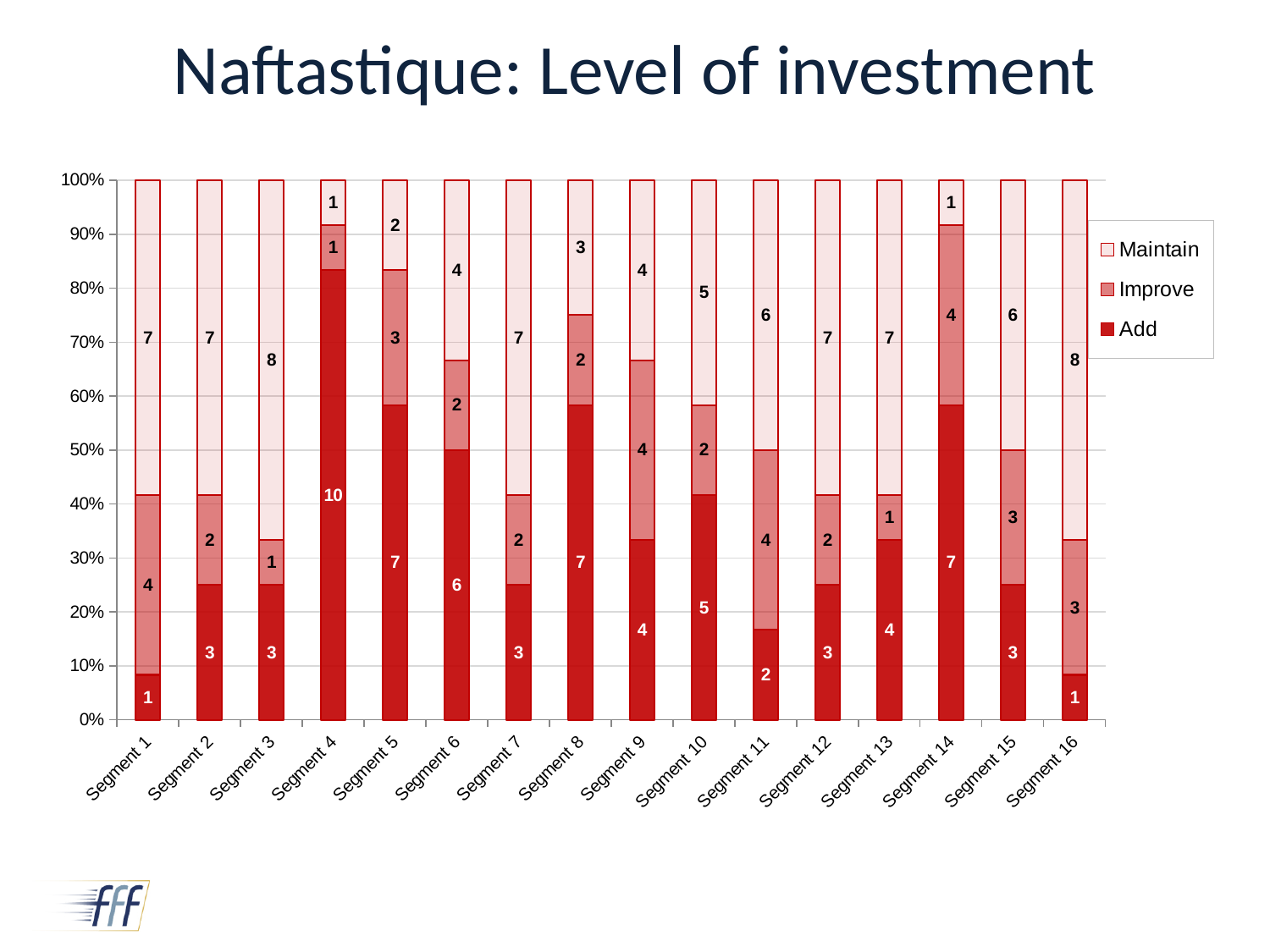
Which segment has the highest Add value? Segment 4 What kind of chart is shown on the slide? Stacked bar chart What is the difference between the Add value for Segment 4 and the Add value for Segment 1? 9 Which is larger, the Add value for Segment 5 or the Add value for Segment 6? Segment 5 What is the total of the Add, Improve and Maintain values for Segment 9? 12 What is the Add value for Segment 4? 10 What is the Maintain value for Segment 16? 8 What is the title of the slide? Naftastique: Level of investment How many segments are shown on the x axis? 16 Is the Add share of the Segment 4 bar greater or less than 80%? greater How many series does the legend list? 3 What is the Improve value for Segment 9? 4